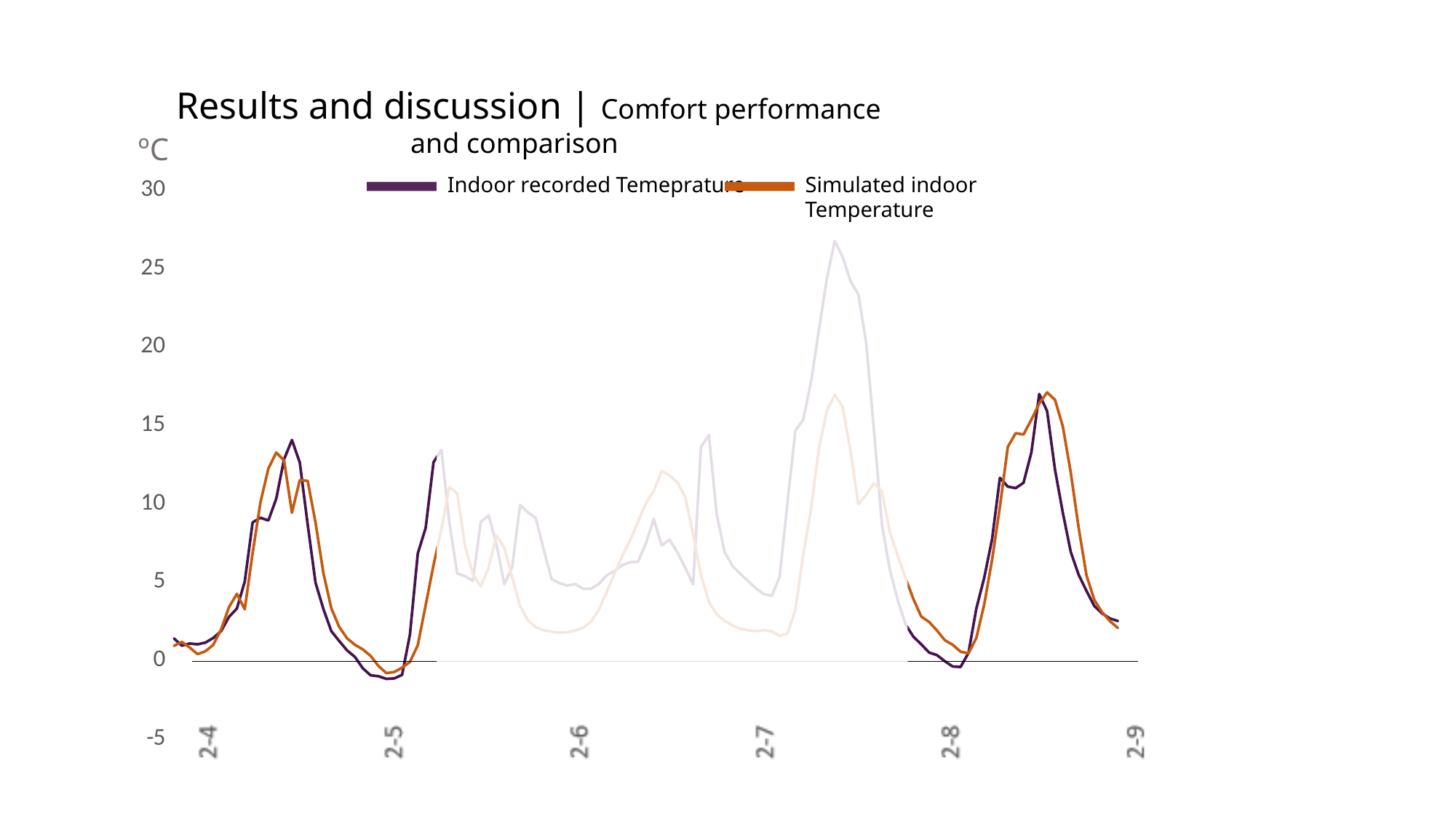
Around 2-5, are the values of both series greater or less than 5? less How many date labels are shown along the x axis? 6 At the peak just after 2-7, which series reaches the higher value, Indoor recorded Temeprature or Simulated indoor Temperature? Indoor recorded Temeprature Is the peak of the Simulated indoor Temperature series just after 2-7 greater or less than 20? less What is the highest value labelled on the vertical axis? 30 What are the two series named in the legend? Indoor recorded Temeprature and Simulated indoor Temperature What kind of chart is shown on the slide? line chart Is the highest peak of the Indoor recorded Temeprature series, just after 2-7, greater or less than 25? greater What unit is shown at the top of the vertical axis? °C How many series does the legend list? 2 What is the lowest value labelled on the vertical axis? -5